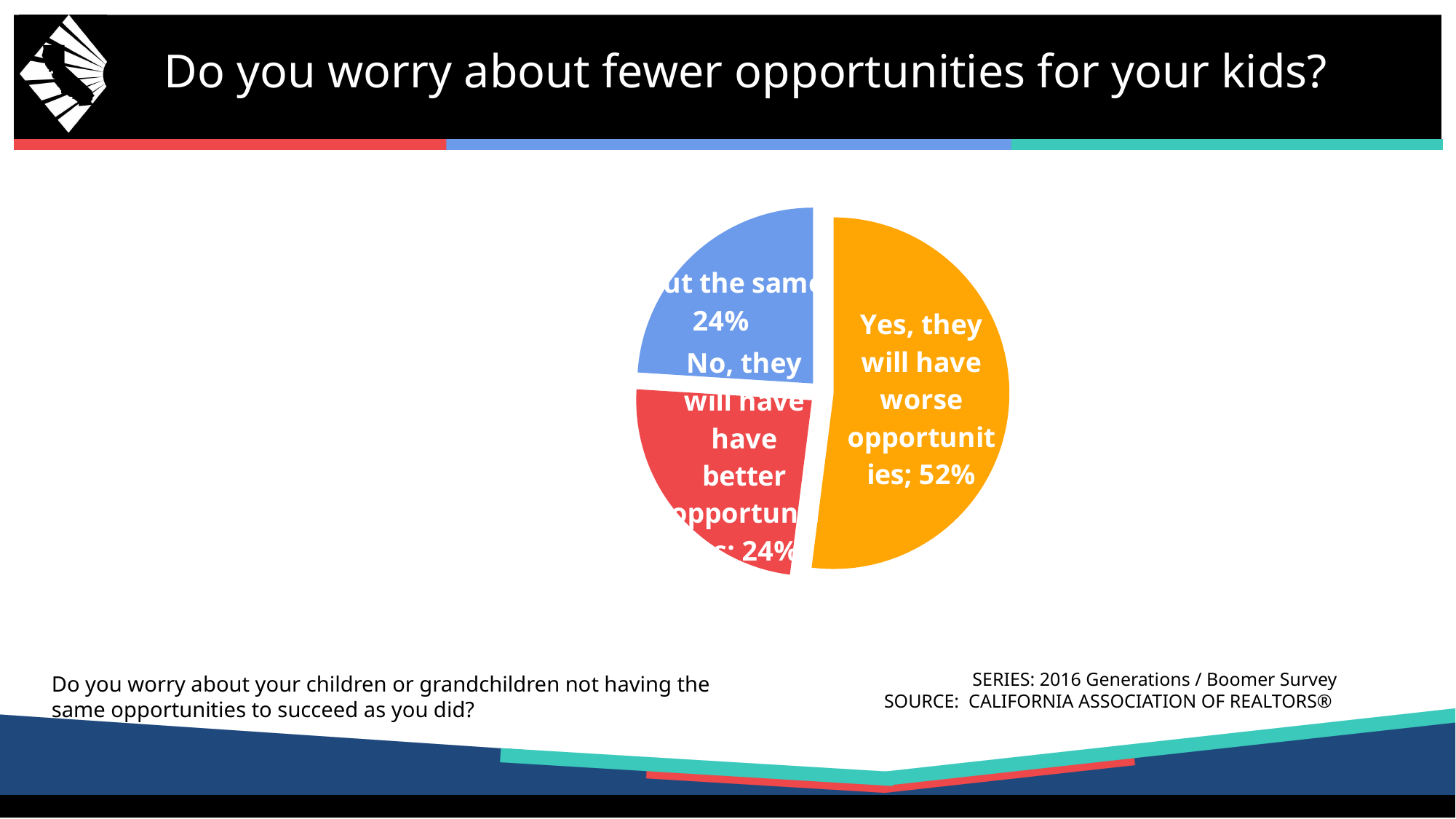
What percentage is shown for the blue "About the same" slice? 24% What percentage of respondents said "Yes, they will have worse opportunities"? 52% Which response has the largest share of the pie? Yes, they will have worse opportunities What colour is the "Yes, they will have worse opportunities" slice? Orange What percentage of respondents said "No, they will have better opportunities"? 24% How many slices does the pie chart have? 3 Which is larger: the share for "Yes, they will have worse opportunities" or the share for "No, they will have better opportunities"? Yes, they will have worse opportunities Is the share for "Yes, they will have worse opportunities" greater or less than 50%? greater What is the difference in percentage points between the "Yes, they will have worse opportunities" slice and the "No, they will have better opportunities" slice? 28% What is the title of the slide containing the pie chart? Do you worry about fewer opportunities for your kids? What is the combined share of the "About the same" and "No, they will have better opportunities" slices? 48% What kind of chart is shown on the slide? Pie chart